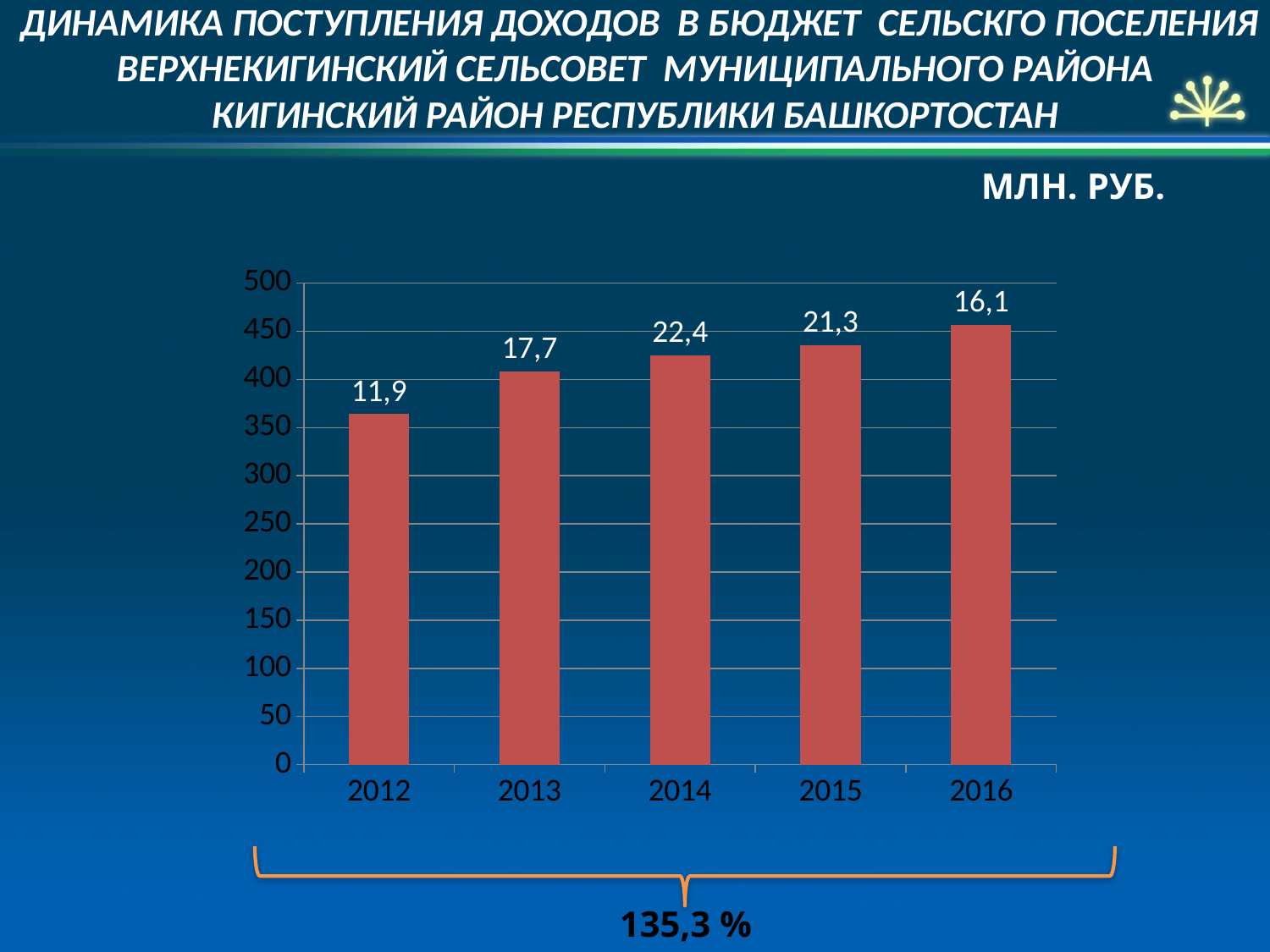
What kind of chart is shown on the slide? bar chart What is the value shown for 2012? 11,9 What is the value shown for 2015? 21,3 What unit of measurement is indicated above the chart? МЛН. РУБ. What is the difference between the labelled values for 2014 and 2013? 4,7 What is the difference between the labelled values for 2013 and 2012? 5,8 What is the difference between the labelled values for 2015 and 2016? 5,2 What is the value shown for 2013? 17,7 What is the value shown for 2016? 16,1 What percentage is written under the bracket below the chart? 135,3 % What is the value shown for 2014? 22,4 How many years are shown on the x axis of the chart? 5